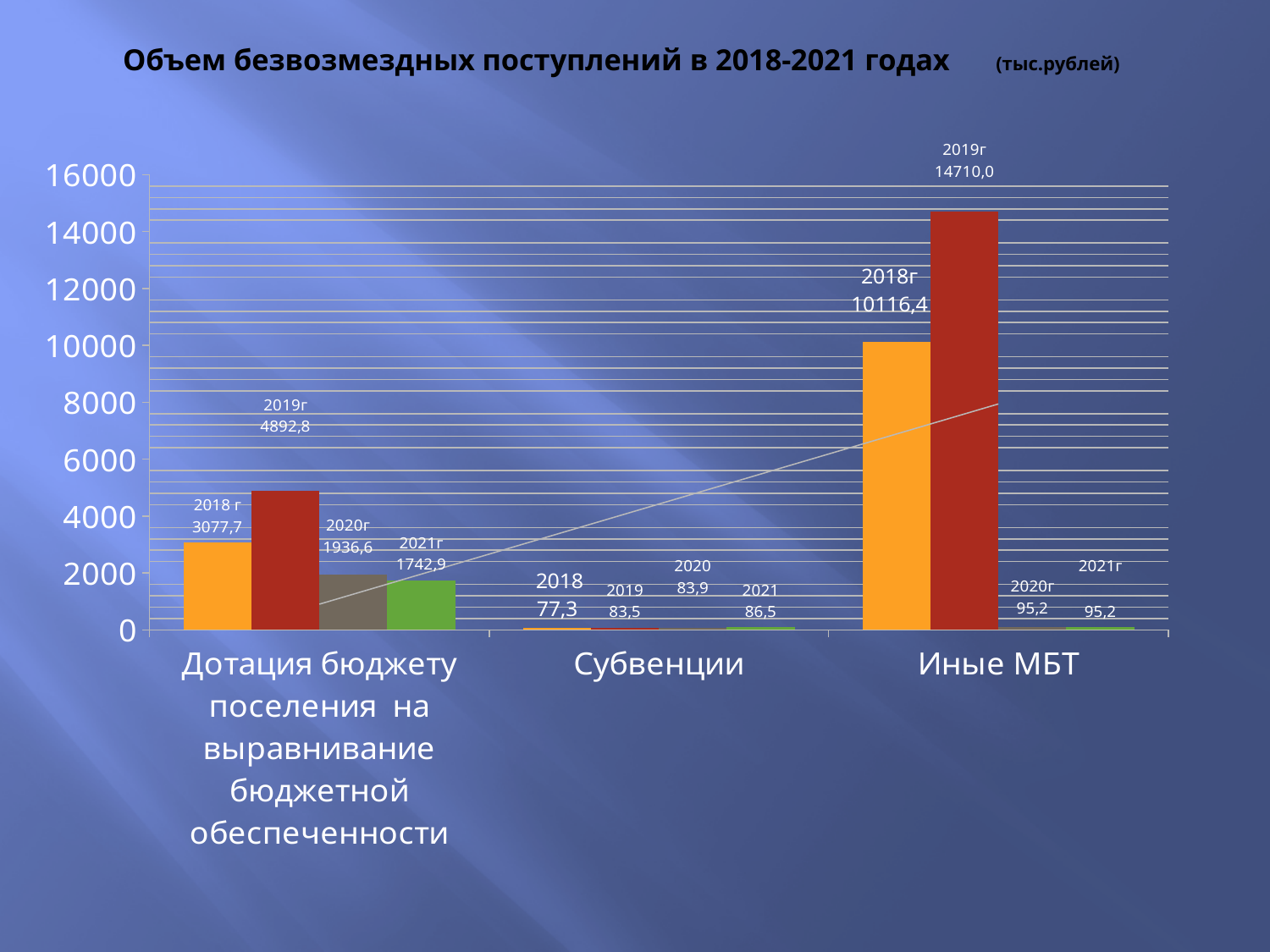
How many categories are shown on the x axis? 3 What unit is given in the chart title? тыс.рублей Which year has the highest value for Дотация бюджету поселения на выравнивание бюджетной обеспеченности? 2019 What is the value for Иные МБТ in 2019? 14710,0 What is the value for Иные МБТ in 2018? 10116,4 Which is larger: the 2020 value for Дотация бюджету поселения or the 2020 value for Иные МБТ? Дотация бюджету поселения What is the value for Дотация бюджету поселения на выравнивание бюджетной обеспеченности in 2020? 1936,6 What is the value for Субвенции in 2021? 86,5 What is the difference between the 2018 and 2021 values for Дотация бюджету поселения на выравнивание бюджетной обеспеченности? 1334,8 What type of chart is shown on the slide? Bar chart Which year has the lowest value for Субвенции? 2018 What is the difference between the 2019 and 2018 values for Иные МБТ? 4593,6